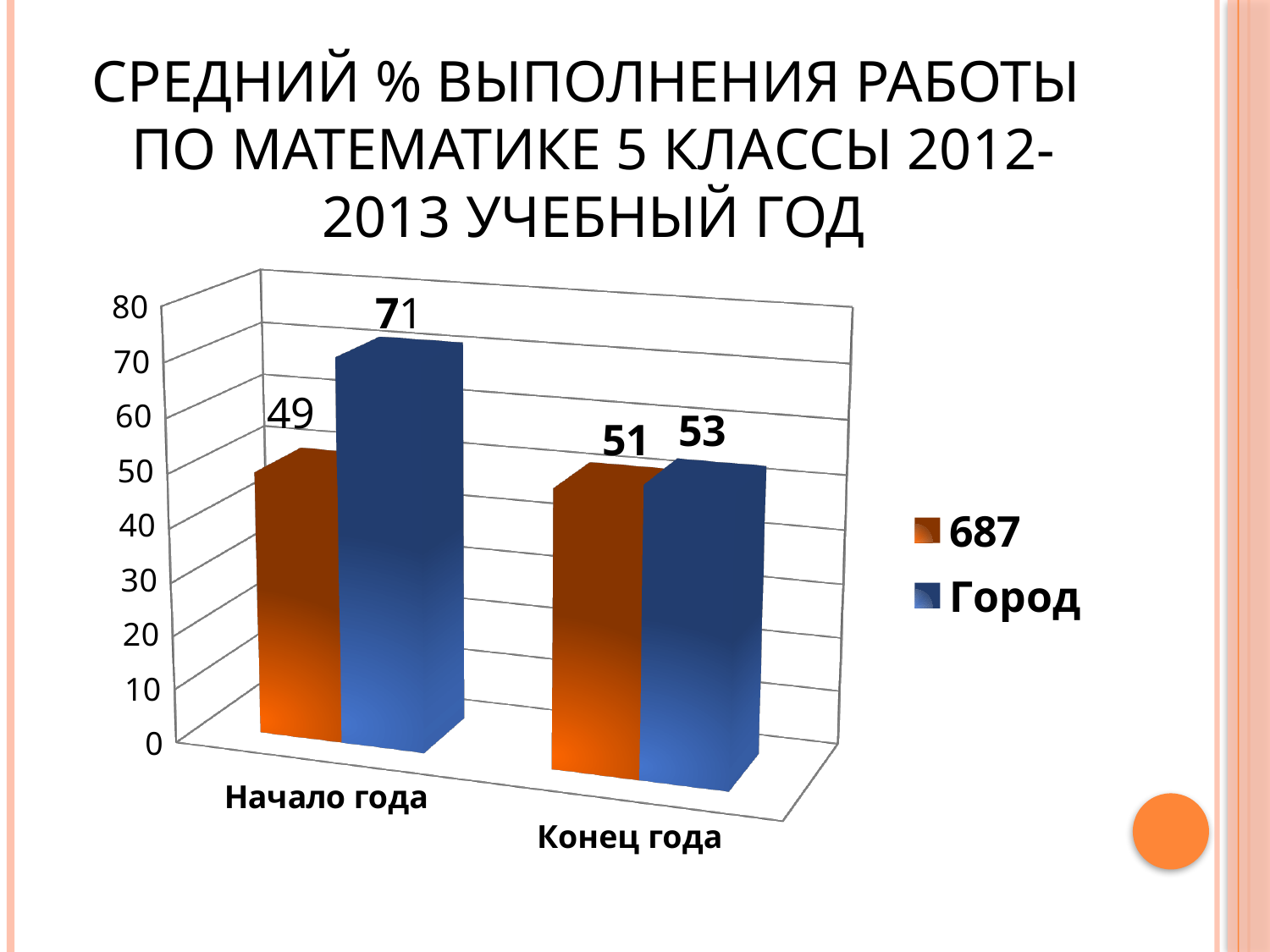
Does the value for Город rise or fall from Начало года to Конец года? Fall How many series does the legend list? 2 What kind of chart is shown on the slide? Bar chart What is the difference between Город and 687 at Начало года? 22 What is the value for Город at Конец года? 53 Which is larger at Начало года: 687 or Город? Город What is the value for Город at Начало года? 71 What is the value for 687 at Начало года? 49 What is the value for 687 at Конец года? 51 Which category has the lowest value for the 687 series? Начало года Which category has the highest value for the Город series? Начало года How many categories are shown on the x axis? 2